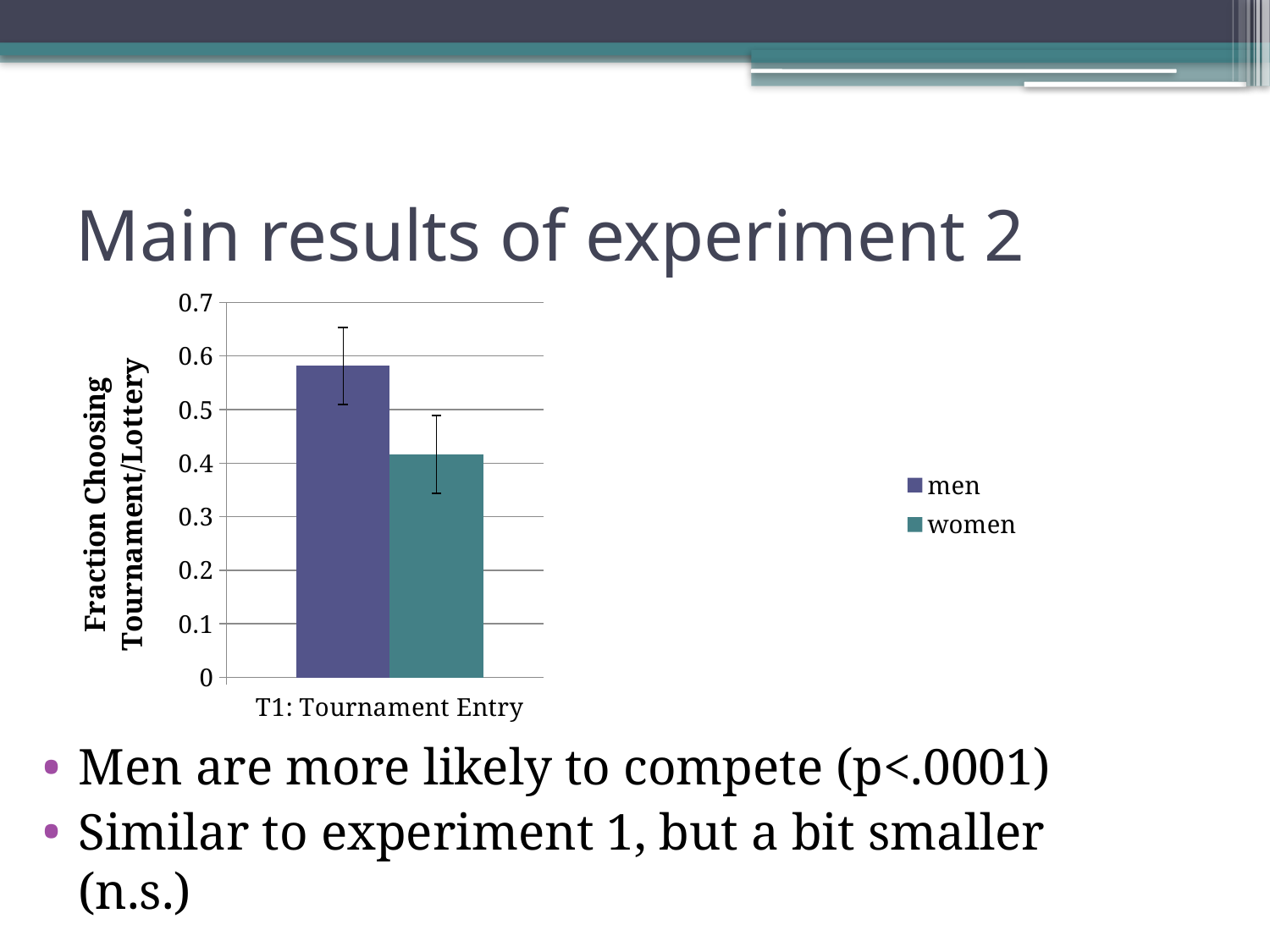
Which series has the higher value for T1: Tournament Entry, men or women? men Is the value for men greater or less than 0.7? less Is the value for men greater or less than 0.5? greater How many categories are shown on the x axis? 1 What is the label on the y axis of the chart? Fraction Choosing Tournament/Lottery Which series has the highest bar in the chart? men Is the value for women greater or less than 0.5? less What kind of chart is shown on the slide? bar chart Which series has the lowest bar in the chart? women How many series does the legend list? 2 What is the category label shown on the x axis? T1: Tournament Entry